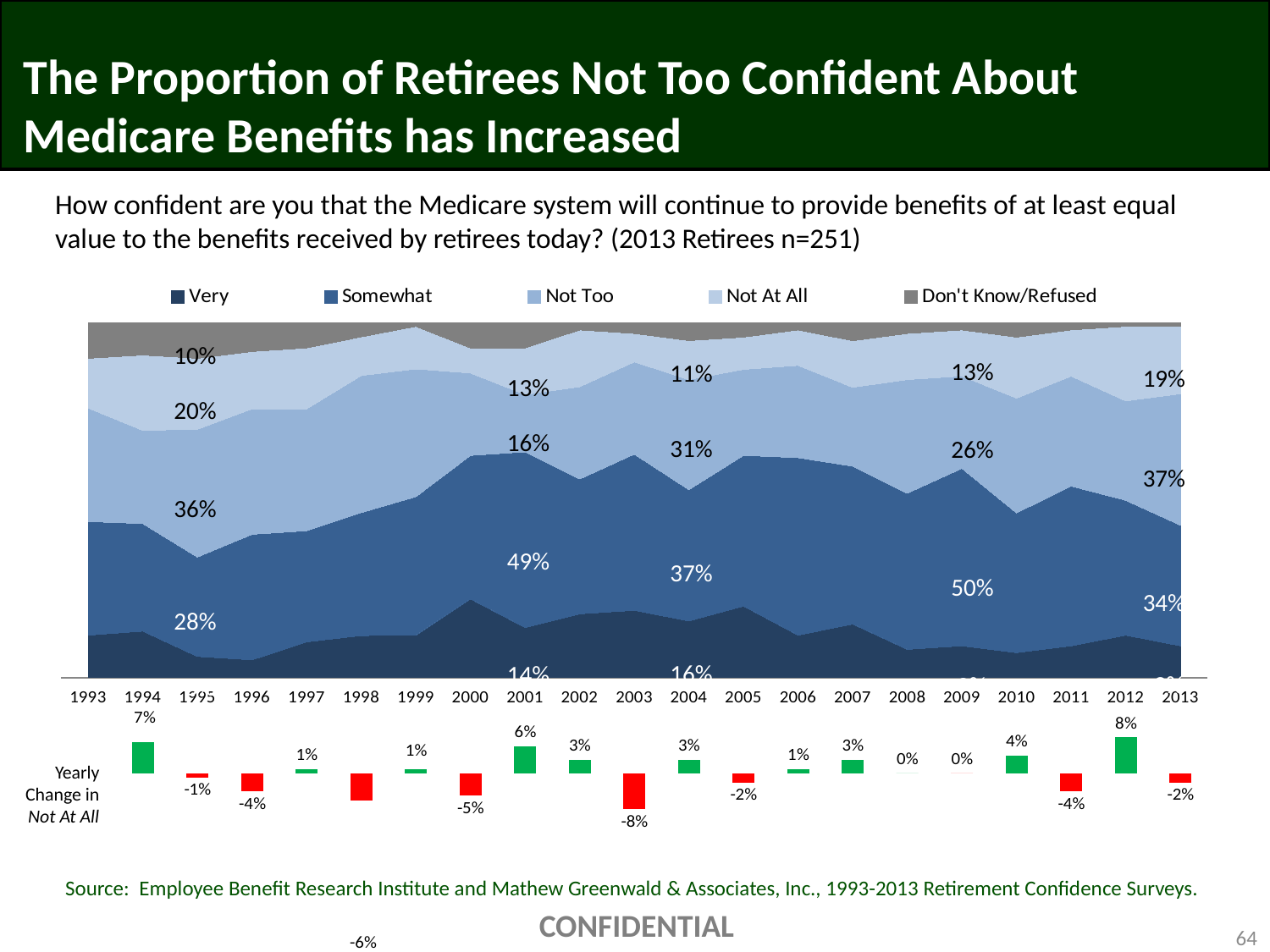
In the upper stacked area chart, is the labelled 'Not At All' value larger in 2004 or in 2013? 2013 How many series does the legend of the upper stacked area chart list? 5 In the upper stacked area chart, what percentage is labelled for 'Not Too' in 2013? 37% In the upper stacked area chart, what percentage is labelled for 'Somewhat' in 2009? 50% How many years are shown on the x axis of the upper stacked area chart? 21 In the lower 'Yearly Change in Not At All' chart, what is the value for 2012? 8% In the lower 'Yearly Change in Not At All' chart, which year has the highest value? 2012 In the lower 'Yearly Change in Not At All' chart, which year has the lowest value? 2003 In the lower 'Yearly Change in Not At All' chart, what is the difference between the 2001 value and the 2002 value? 3 percentage points In the lower 'Yearly Change in Not At All' chart, what is the value for 2003? -8% Which series is listed first in the legend of the upper stacked area chart? Very What kind of chart is the lower chart labelled 'Yearly Change in Not At All'? bar chart